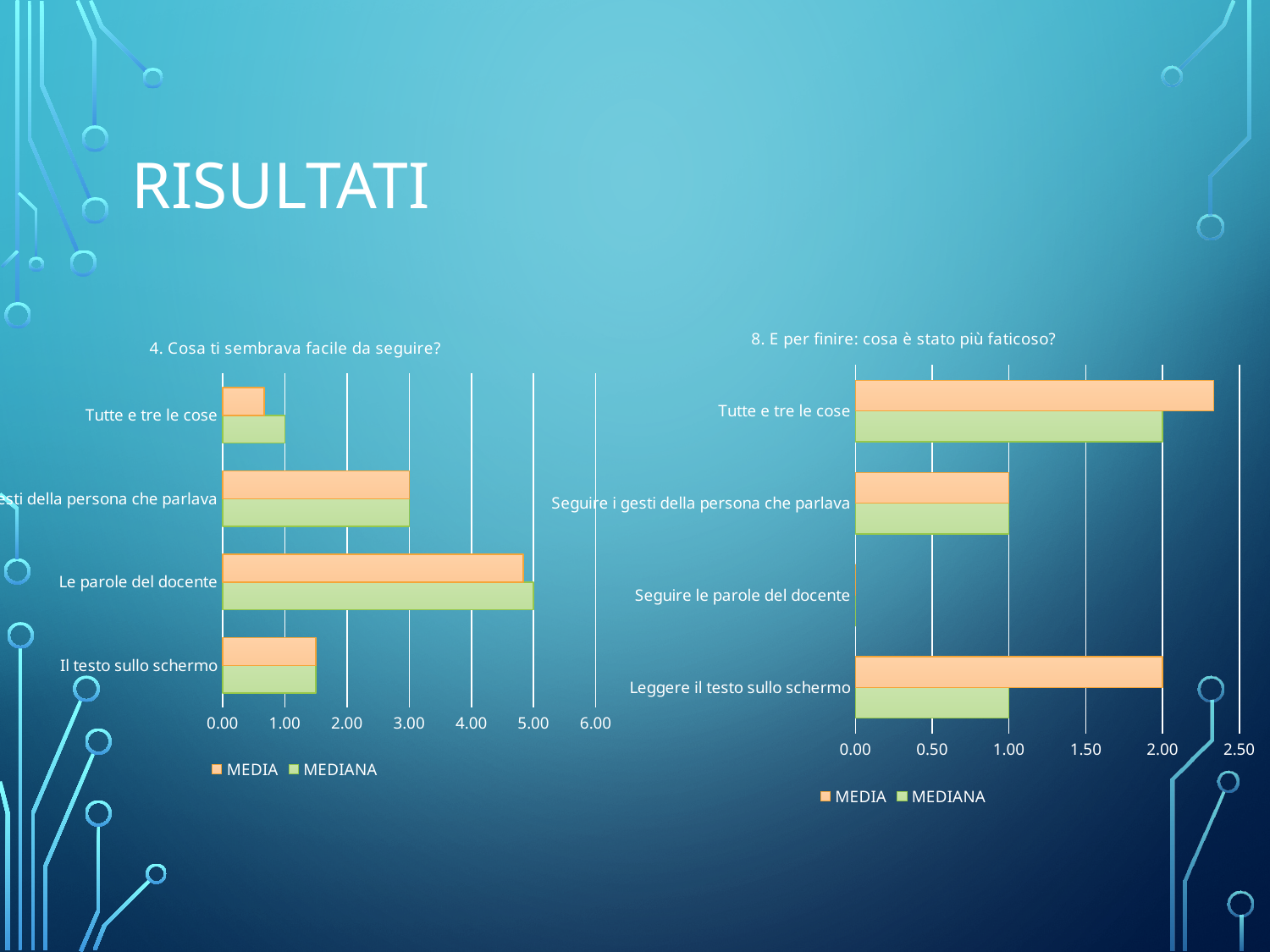
In the chart titled "4. Cosa ti sembrava facile da seguire?", is the MEDIA value for Tutte e tre le cose greater or less than 1.00? less In the chart titled "8. E per finire: cosa è stato più faticoso?", which category has the lowest MEDIA value? Seguire le parole del docente In the chart titled "8. E per finire: cosa è stato più faticoso?", which is larger for Leggere il testo sullo schermo, MEDIA or MEDIANA? MEDIA In the chart titled "4. Cosa ti sembrava facile da seguire?", which category has the lowest MEDIA value? Tutte e tre le cose In the chart titled "8. E per finire: cosa è stato più faticoso?", which category has the highest MEDIA value? Tutte e tre le cose In the chart titled "4. Cosa ti sembrava facile da seguire?", how many series does the legend list? 2 In the chart titled "8. E per finire: cosa è stato più faticoso?", is the MEDIA value for Tutte e tre le cose greater or less than 2.00? greater What kind of chart is the chart titled "4. Cosa ti sembrava facile da seguire?"? bar chart How many categories are shown in the chart titled "8. E per finire: cosa è stato più faticoso?"? 4 What are the two legend entries in the chart titled "8. E per finire: cosa è stato più faticoso?"? MEDIA and MEDIANA In the chart titled "4. Cosa ti sembrava facile da seguire?", which category has the highest MEDIA value? Le parole del docente In the chart titled "4. Cosa ti sembrava facile da seguire?", is the MEDIA value for Le parole del docente greater or less than 4.00? greater